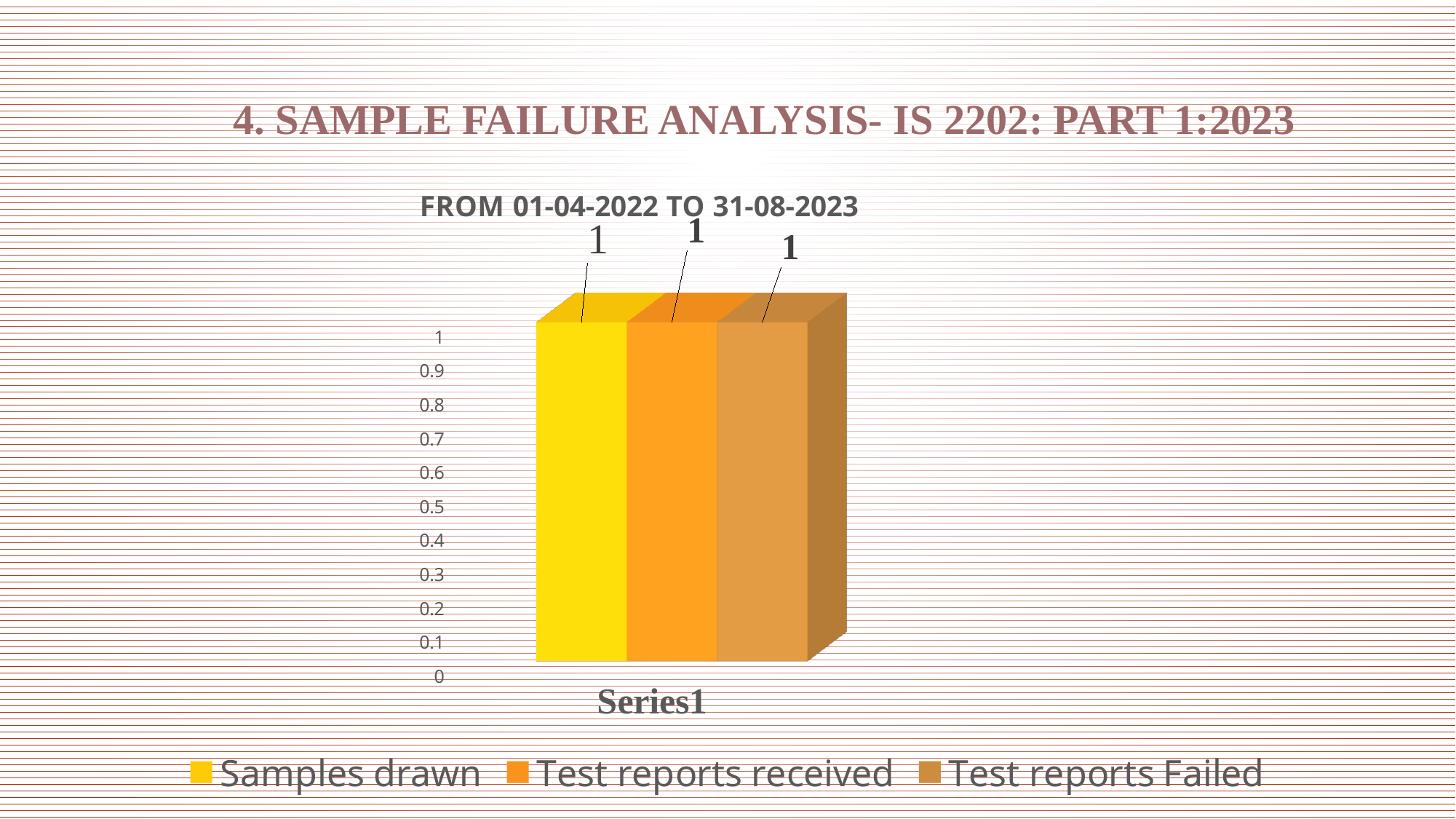
How many series does the legend list? 3 What is the highest value shown on the y axis? 1 What kind of chart is shown on the slide? bar chart What is the label of the category on the x axis? Series1 Is the value for Test reports received greater or less than 0.5? greater What is the value for Test reports Failed? 1 What is the value for Test reports received? 1 What is the title of the chart? FROM 01-04-2022 TO 31-08-2023 What is the value for Samples drawn? 1 How many categories are shown on the x axis? 1 What is the difference between Samples drawn and Test reports Failed? 0